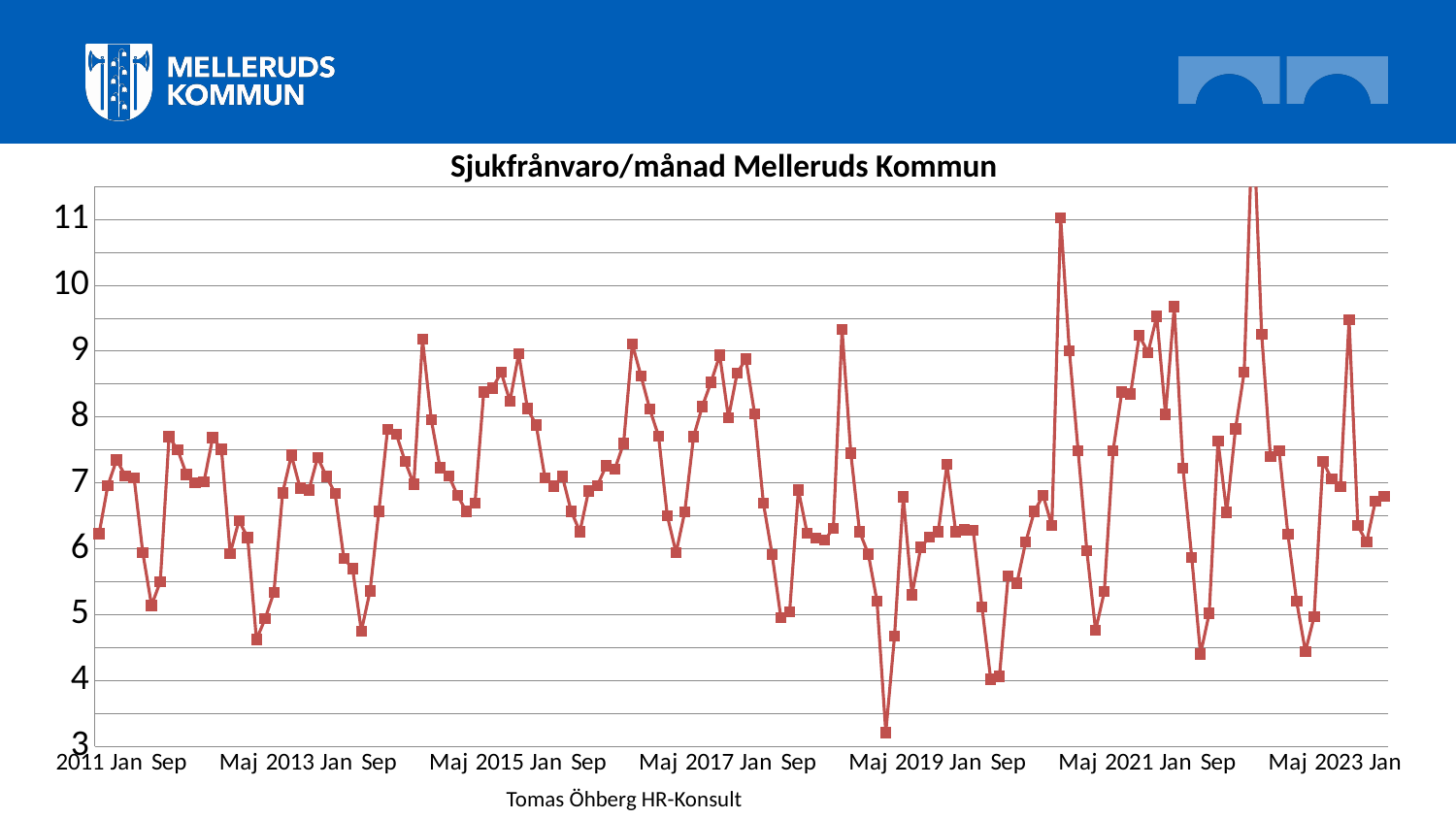
What is the title of the chart? Sjukfrånvaro/månad Melleruds Kommun Which is larger: the value for 2021 Jan or the value for 2011 Jan? 2021 Jan Is the highest point on the chart greater or less than 11? greater Is the lowest point on the chart greater or less than 4? less Is the value for 2017 Jan greater or less than 7? greater What is the lowest value shown on the vertical axis? 3 What kind of chart is shown on the slide? Line chart How many data series are plotted on the chart? 1